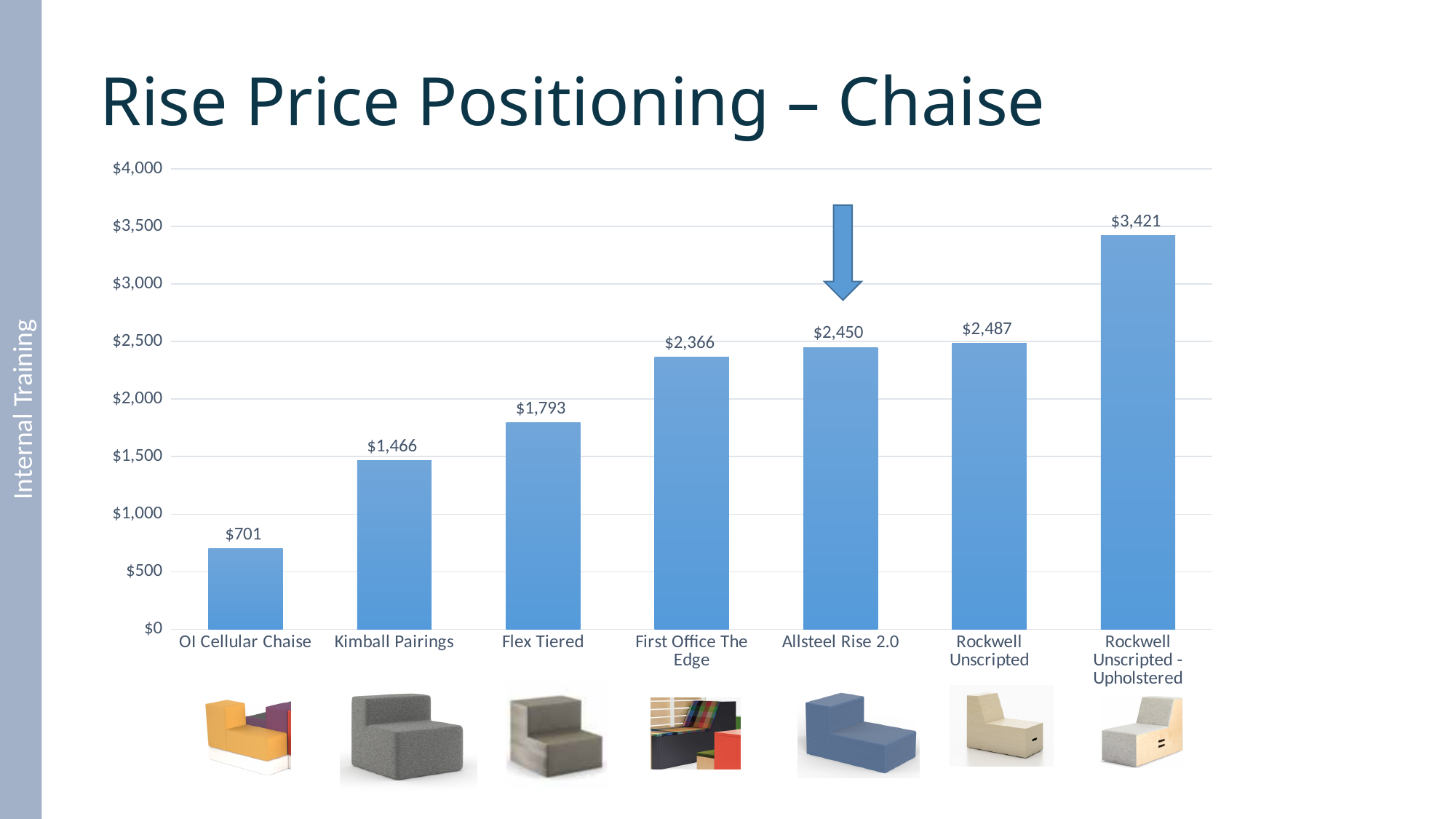
Which is priced higher, Kimball Pairings or Flex Tiered? Flex Tiered What is the difference in price between First Office The Edge and Flex Tiered? $573 What is the price shown for Kimball Pairings? $1,466 Which product has the highest price on the chart? Rockwell Unscripted - Upholstered What kind of chart is shown on the slide? bar chart Do the prices rise or fall from left to right across the chart? rise What is the price shown for Allsteel Rise 2.0? $2,450 Which product has the lowest price on the chart? OI Cellular Chaise What is the price shown for Flex Tiered? $1,793 Is the value for OI Cellular Chaise greater or less than $1,000? less How many products are shown on the chart? 7 What is the difference in price between Rockwell Unscripted - Upholstered and Allsteel Rise 2.0? $971